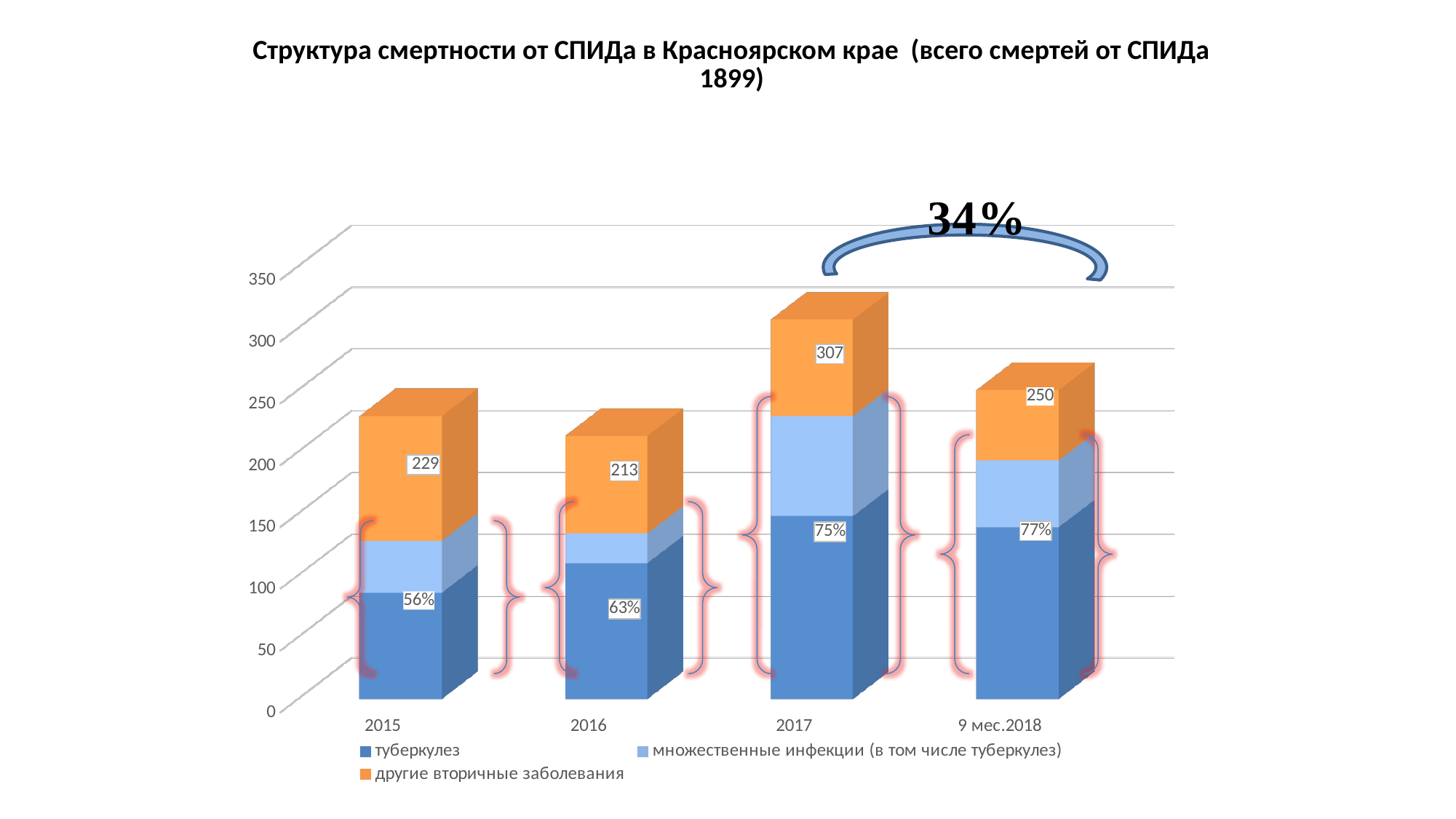
How many categories (time periods) are shown on the x axis? 4 What total value is labelled on the bar for 2016? 213 Which labelled total is larger, 2015 or 2016? 2015 Do the туберкулез percentages rise or fall from 2015 to 9 мес.2018? rise How many series does the legend list? 3 Which period has the lowest labelled total? 2016 What is the difference between the labelled totals for 2017 and 2016? 94 What total value is labelled on the bar for 2017? 307 What percentage is labelled on the туберкулез segment for 2015? 56% Which period has the highest labelled total? 2017 What kind of chart is shown on the slide? stacked bar chart What percentage is labelled on the туберкулез segment for 9 мес.2018? 77%